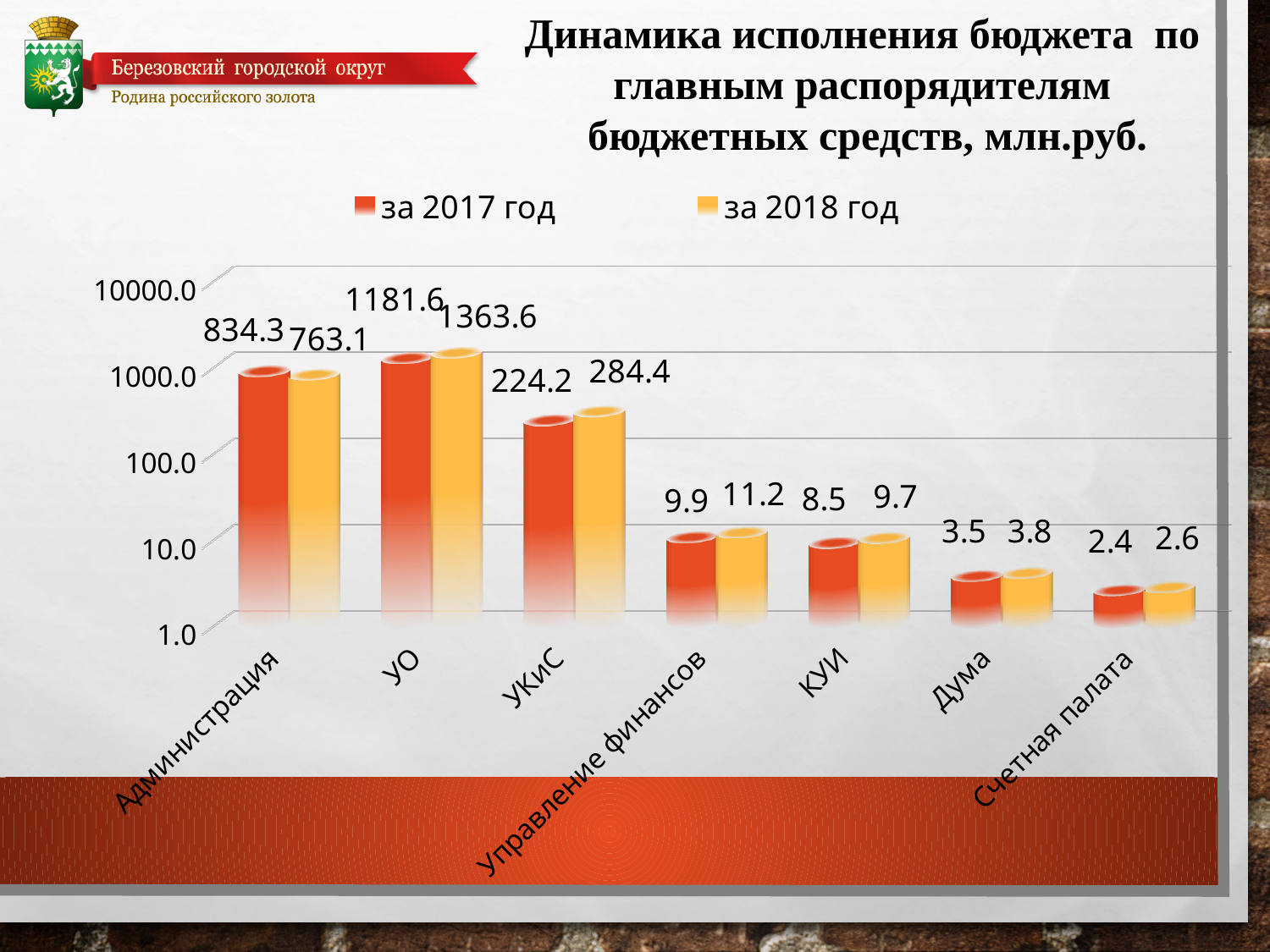
Which is larger for Администрация: the value for за 2017 год or за 2018 год? за 2017 год Which category has the highest value in the series за 2018 год? УО How many categories are shown on the x axis? 7 What is the value for Счетная палата in the series за 2018 год? 2.6 What kind of chart is shown on the slide? bar chart What is the value for Дума in the series за 2017 год? 3.5 What is the value for УО in the series за 2018 год? 1363.6 Which category has the lowest value in the series за 2017 год? Счетная палата How many series does the legend list? 2 What is the value for УКиС in the series за 2017 год? 224.2 What is the difference between the за 2018 год and за 2017 год values for УКиС? 60.2 What is the value for Администрация in the series за 2017 год? 834.3